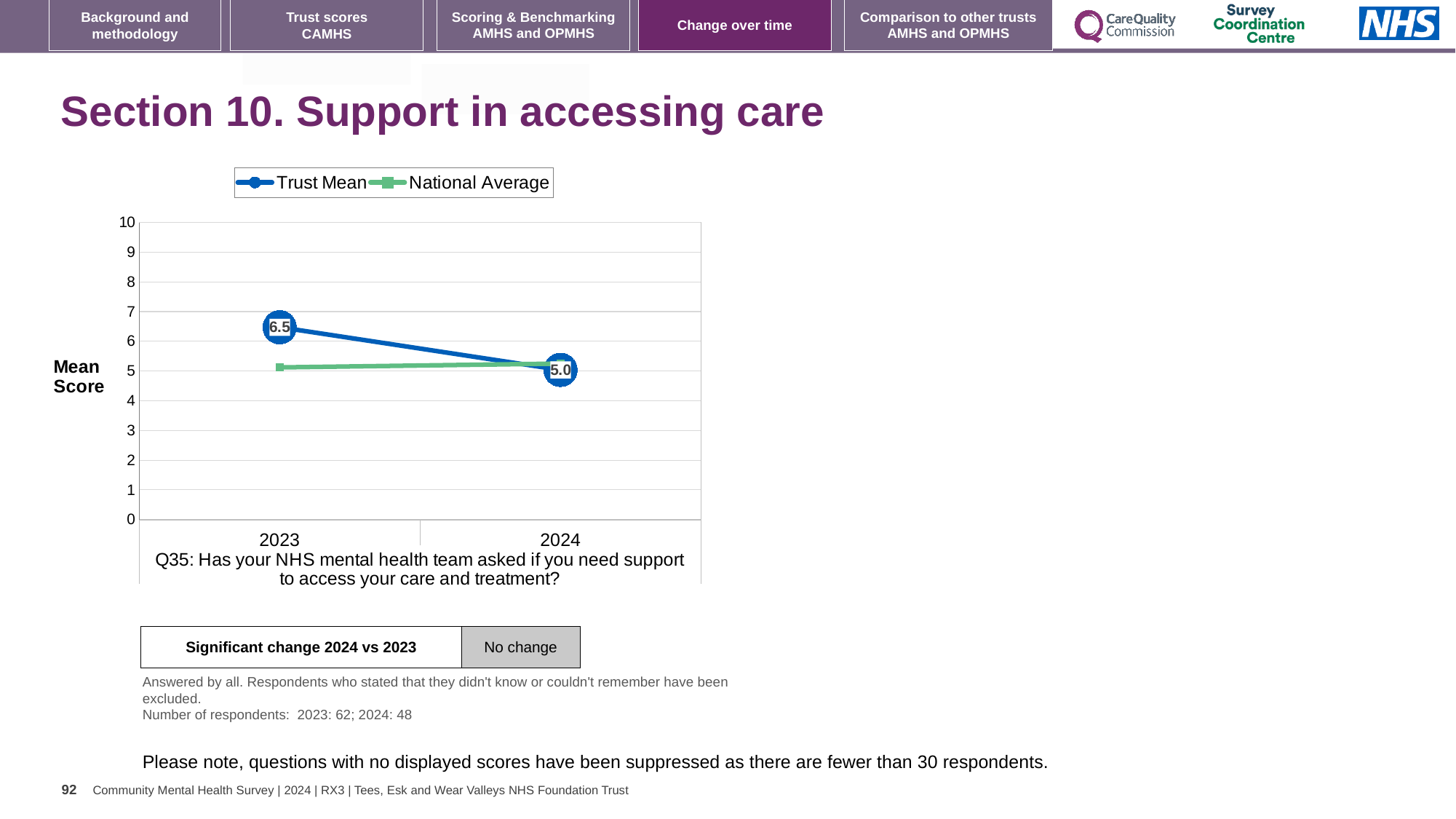
In 2023, which is larger: the Trust Mean or the National Average? Trust Mean What is the difference between the Trust Mean in 2023 and in 2024? 1.5 In which year is the Trust Mean highest? 2023 What is the Trust Mean value for 2023? 6.5 Does the Trust Mean rise or fall from 2023 to 2024? fall Is the National Average value for 2024 greater or less than 4? greater In which year is the Trust Mean lowest? 2024 How many years are shown on the x axis? 2 What kind of chart is shown on the slide? line chart Is the National Average value for 2023 greater or less than 6? less What is the Trust Mean value for 2024? 5.0 How many series does the legend list? 2